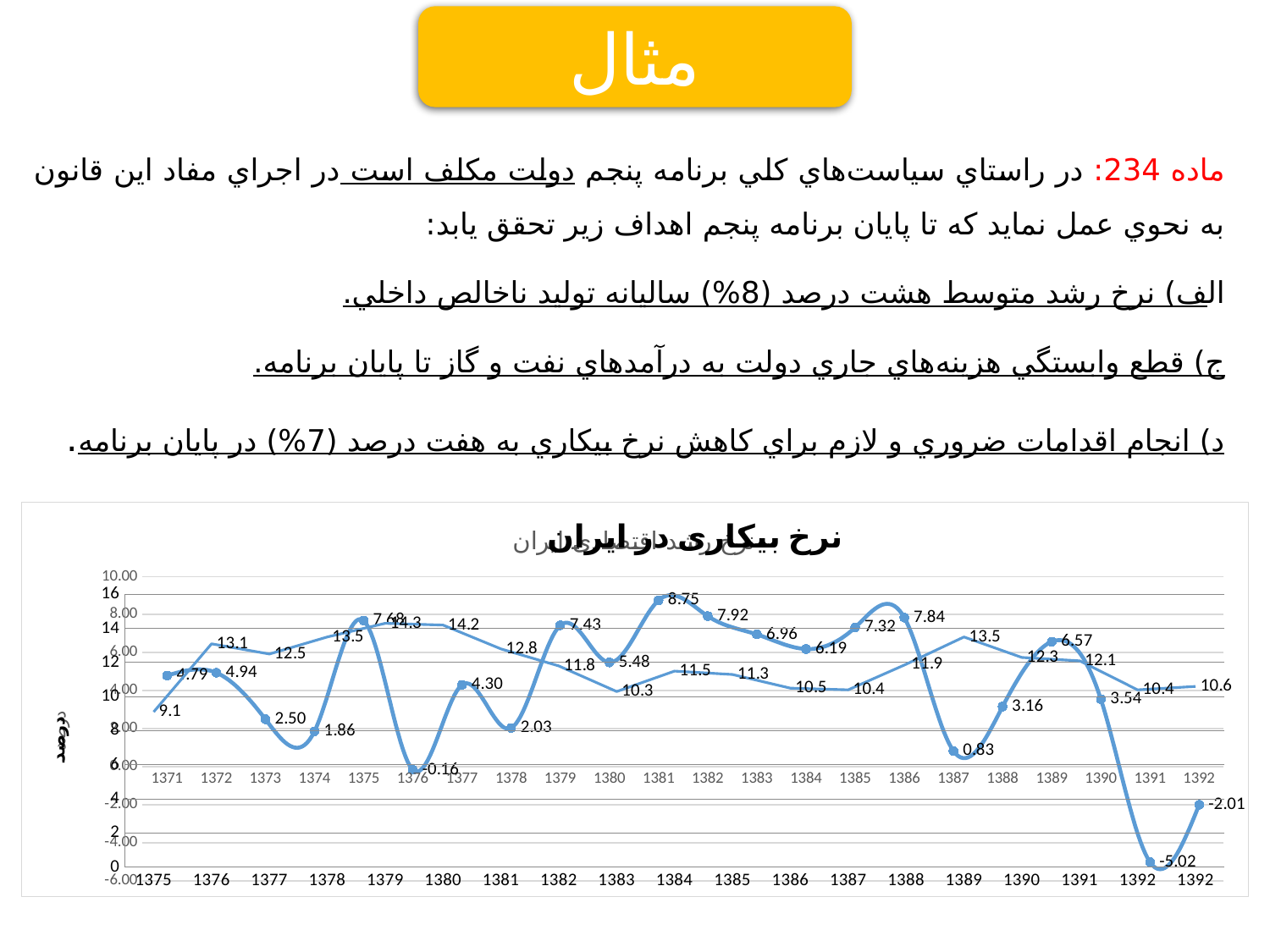
In the unemployment rate chart (نرخ بیکاری در ایران), what is the highest value shown? 14.3 In the economic growth chart (the line whose x axis starts at 1371), what is the difference between the highest value (8.75) and the lowest value (-5.02)? 13.77 What type of chart is used for the unemployment rate chart titled نرخ بیکاری در ایران? Line chart In the economic growth chart (the line whose x axis starts at 1371), how many data points are plotted? 22 In the unemployment rate chart (نرخ بیکاری در ایران), what is the value for 1379? 14.3 In the unemployment rate chart (نرخ بیکاری در ایران), does the line rise or fall from 1375 to 1379? Rise In the economic growth chart (the line whose x axis starts at 1371), what is the lowest value shown? -5.02 In the economic growth chart (the line whose x axis starts at 1371), what is the highest value shown? 8.75 In the economic growth chart (the line whose x axis starts at 1371), what is the value for 1376? -0.16 In the unemployment rate chart (نرخ بیکاری در ایران), what is the lowest value shown? 9.1 In the unemployment rate chart (نرخ بیکاری در ایران), what is the value for 1375? 9.1 In the economic growth chart (the line whose x axis starts at 1371), what is the value for 1387? 0.83